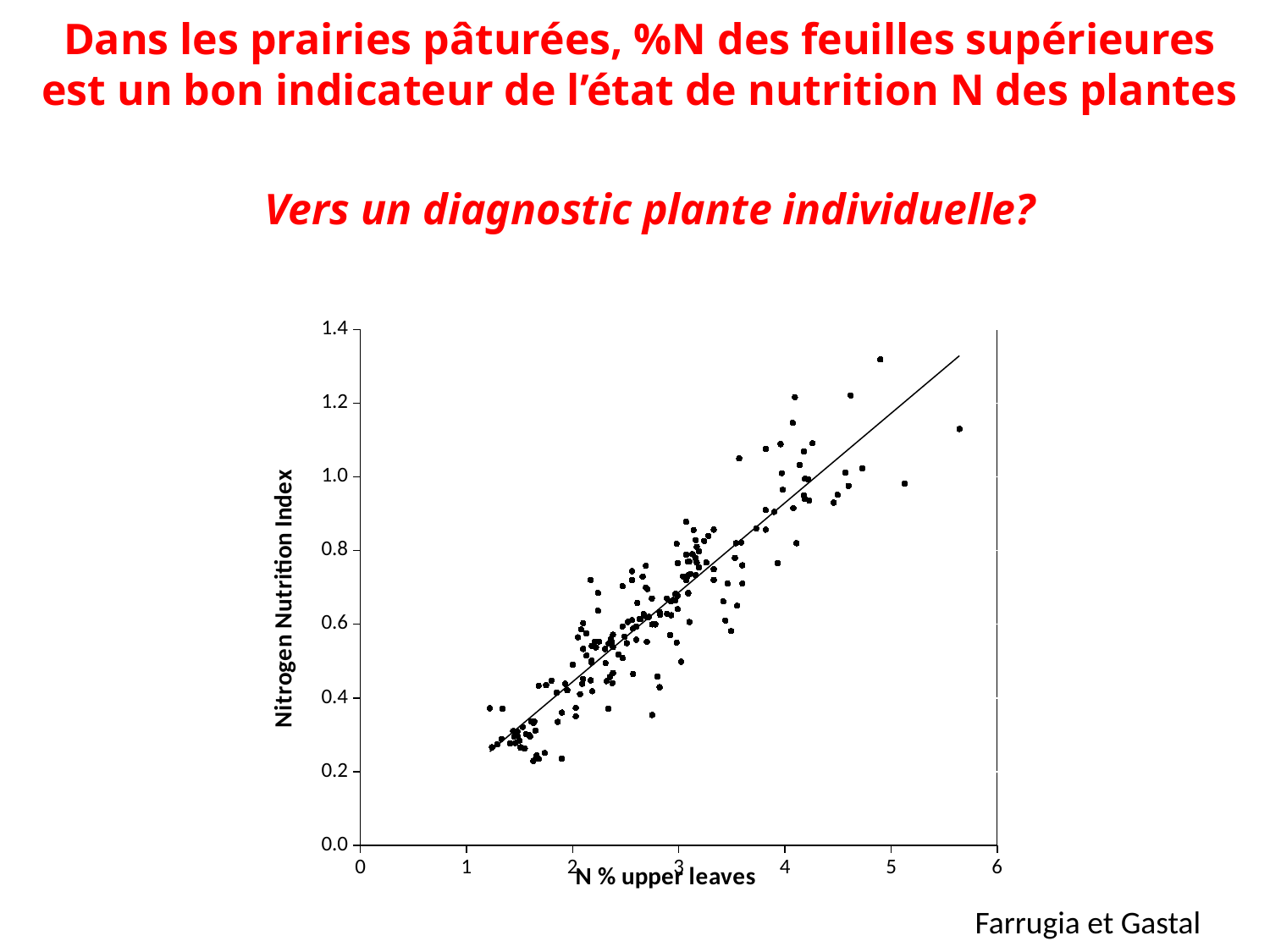
What is the label of the x axis of the chart? N % upper leaves Is the Nitrogen Nutrition Index of the lowest point on the chart greater or less than 0.4? less Is the Nitrogen Nutrition Index of the highest point on the chart greater or less than 1.2? greater Is the N % upper leaves value of the rightmost point on the chart greater or less than 5? greater What is the label of the y axis of the chart? Nitrogen Nutrition Index What kind of chart is shown on the slide? scatter chart Do the Nitrogen Nutrition Index values rise or fall as N % upper leaves increases along the x axis? rise